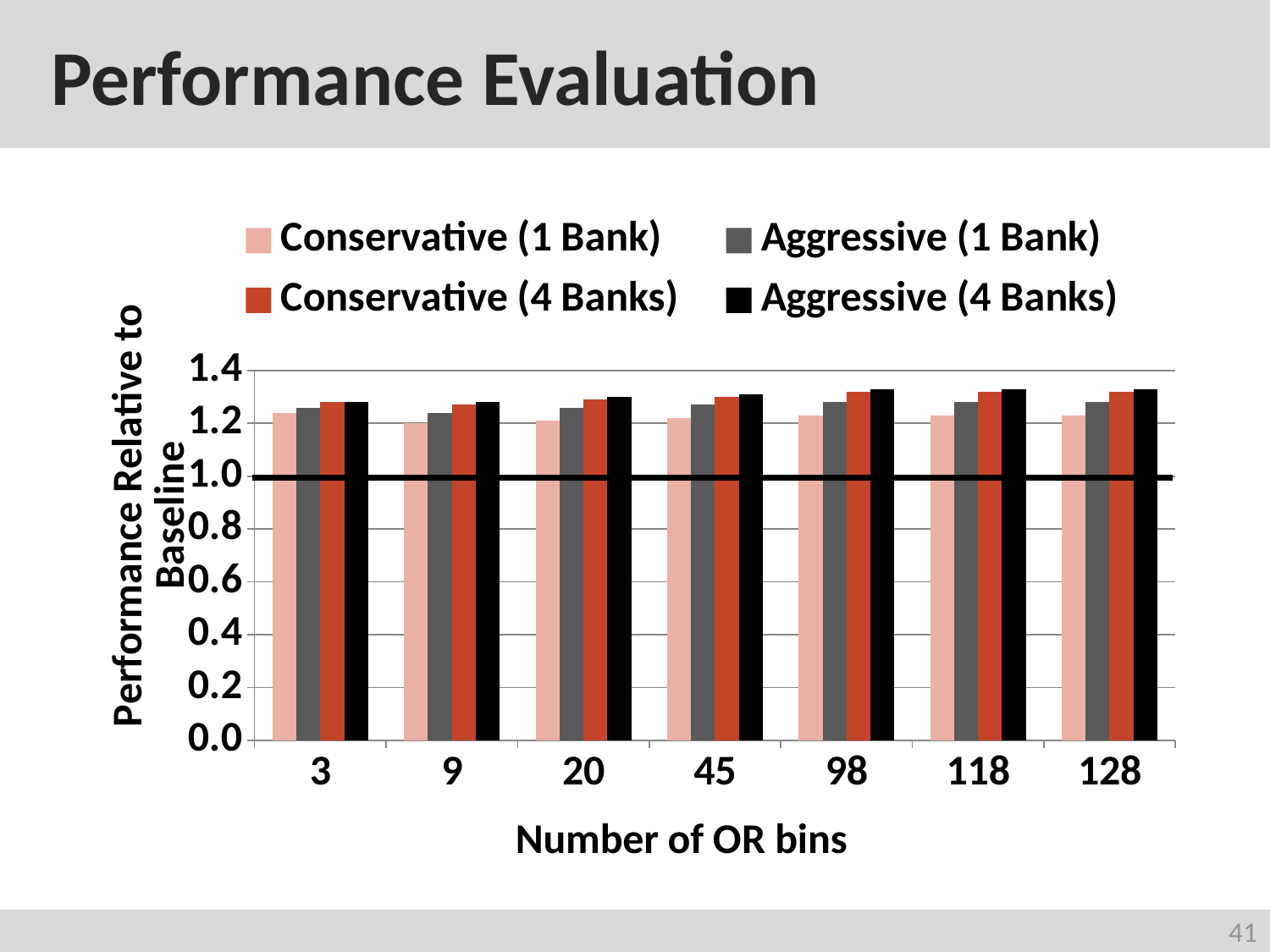
What is the title of the x axis? Number of OR bins At 9 OR bins, which is larger: Conservative (1 Bank) or Conservative (4 Banks)? Conservative (4 Banks) What kind of chart is shown on the slide? bar chart How many series does the legend list? 4 Is the value for Conservative (1 Bank) at 3 OR bins greater or less than 1.0? greater Is the value for Aggressive (4 Banks) at 98 OR bins greater or less than 1.2? greater How many categories (numbers of OR bins) are shown on the x axis? 7 Is the value for Conservative (4 Banks) at 3 OR bins greater or less than 1.4? less What is the title of the y axis? Performance Relative to Baseline At 98 OR bins, which is larger: Conservative (1 Bank) or Aggressive (4 Banks)? Aggressive (4 Banks)